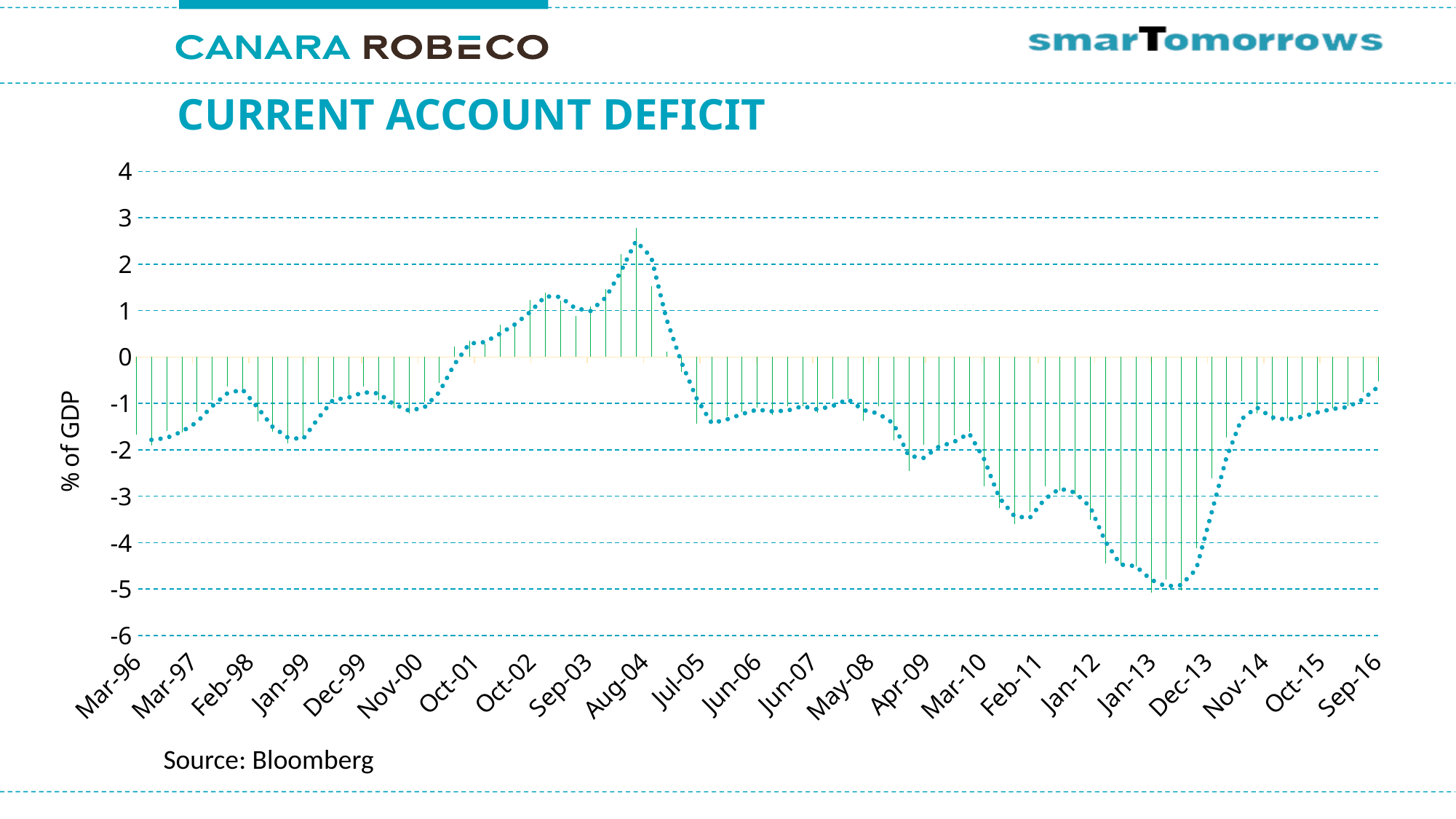
Around which labelled date does the line reach its lowest value? Jan-13 Do the values rise or fall between Jan-13 and Nov-14? rise Is the value at Oct-02 greater or less than 1? greater Do the values rise or fall between Aug-04 and Jul-05? fall Is the value at Aug-04 greater or less than 2? greater Is the value at Sep-16 greater or less than -1? greater Around which labelled date does the line reach its highest value? Aug-04 What kind of chart is shown on the slide? bar chart What is the label on the vertical axis? % of GDP